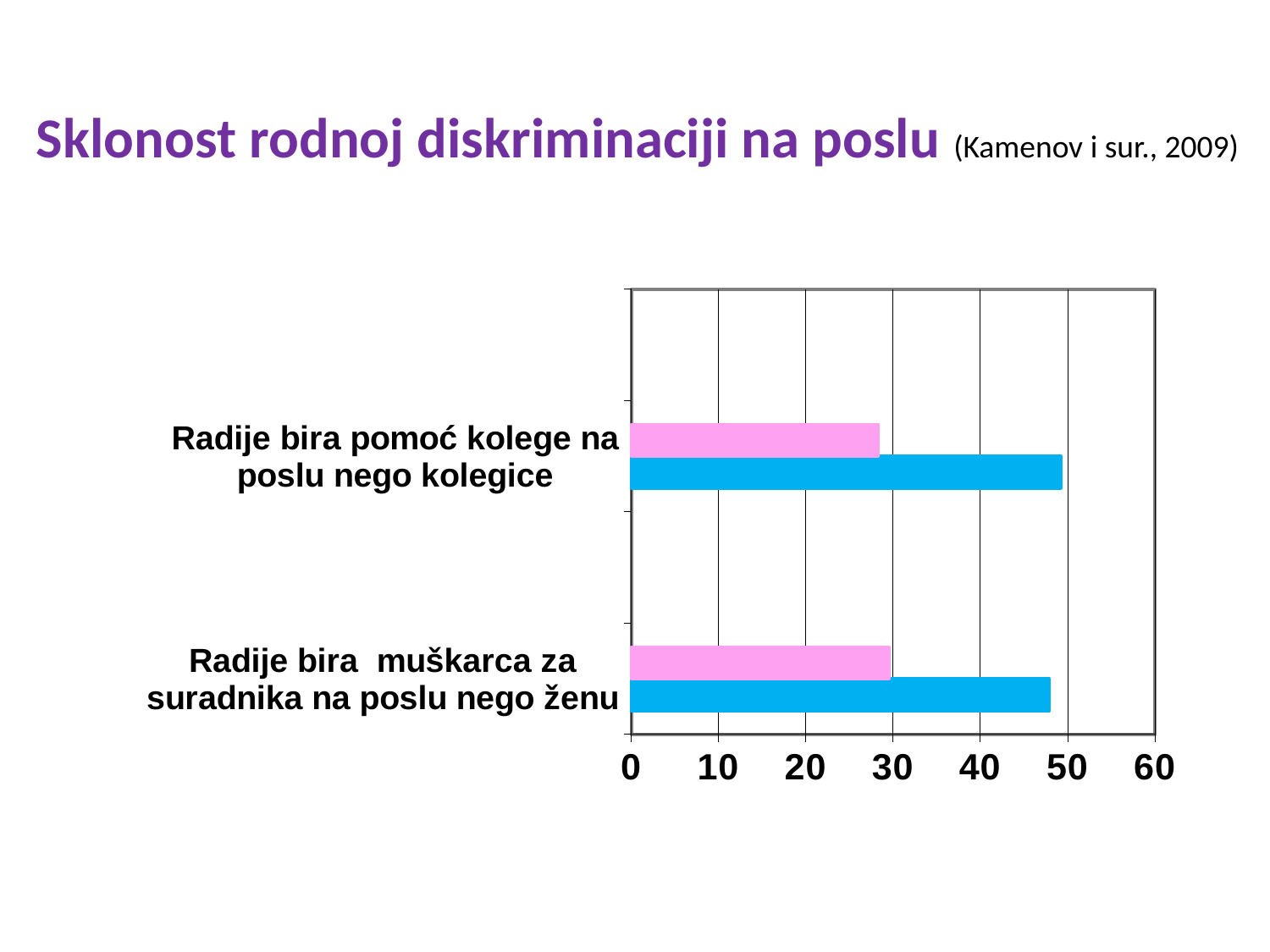
For "Radije bira pomoć kolege na poslu nego kolegice", is the pink bar greater or less than 30? less How many categories are shown on the chart? 2 For "Radije bira pomoć kolege na poslu nego kolegice", is the blue bar greater or less than 40? greater For "Radije bira muškarca za suradnika na poslu nego ženu", which bar is longer, the pink one or the blue one? the blue one For "Radije bira muškarca za suradnika na poslu nego ženu", is the pink bar greater or less than 20? greater What is the title of the slide containing the chart? Sklonost rodnoj diskriminaciji na poslu What kind of chart is shown on the slide? bar chart What is the maximum value shown on the horizontal axis of the chart? 60 For "Radije bira pomoć kolege na poslu nego kolegice", which bar is longer, the pink one or the blue one? the blue one What two colours are used for the bars in the chart? pink and blue